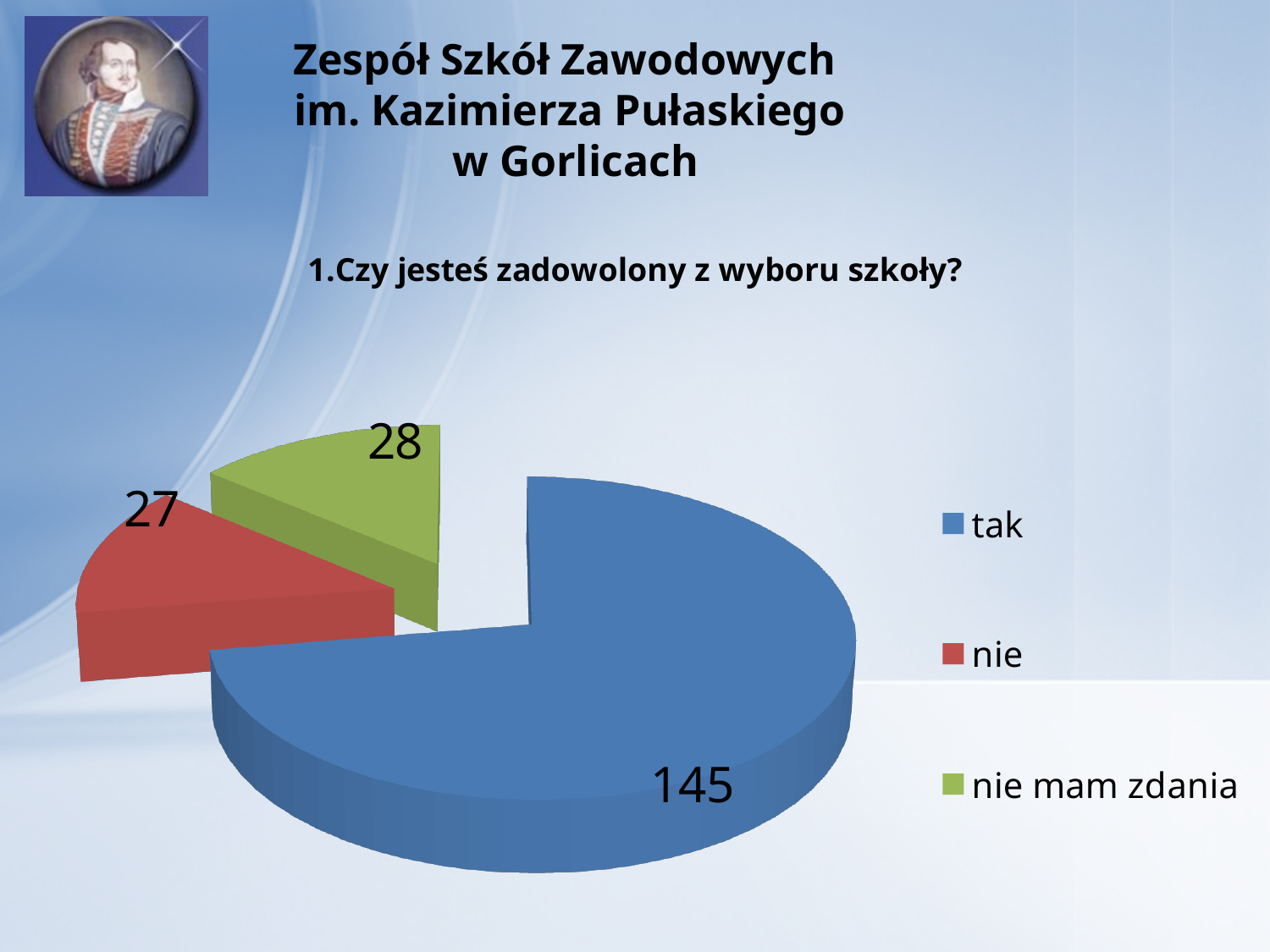
What is the total of all slices in the pie chart? 200 What is the difference between the values for "nie mam zdania" and "nie"? 1 What type of chart is shown on the slide? pie chart What is the value for "nie mam zdania"? 28 Which category has the lowest value? nie Which is larger, the value for "tak" or the value for "nie mam zdania"? tak What is the value for "nie"? 27 Which category has the highest value? tak What is the difference between the values for "tak" and "nie"? 118 What is the value for "tak"? 145 What share of the pie does the "tak" slice represent? 72.5% How many slices does the pie chart have? 3